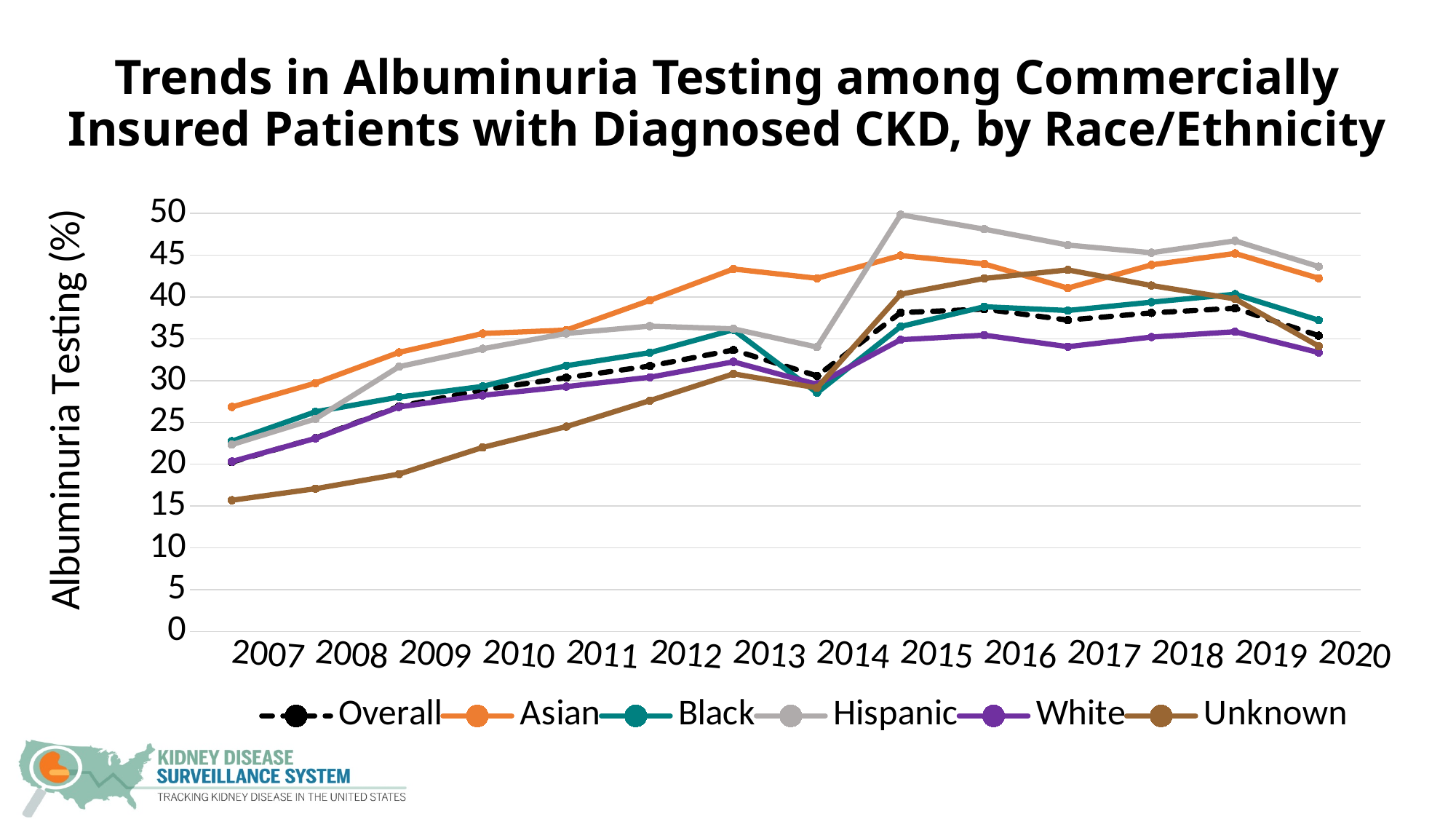
Does the Unknown series rise or fall from 2007 to 2012? rise How many years are shown along the x axis? 14 How many series does the legend list? 6 Is the value for Hispanic in 2015 greater or less than 45? greater Which race/ethnicity series has the highest albuminuria testing value in 2015? Hispanic Which is larger in 2012, the value for Asian or the value for White? Asian Which series has the highest value in 2017? Hispanic Which series has the lowest albuminuria testing value in 2007? Unknown Which series is drawn with a dashed line? Overall What kind of chart is shown on the slide? line chart Is the value for Unknown in 2007 greater or less than 20? less